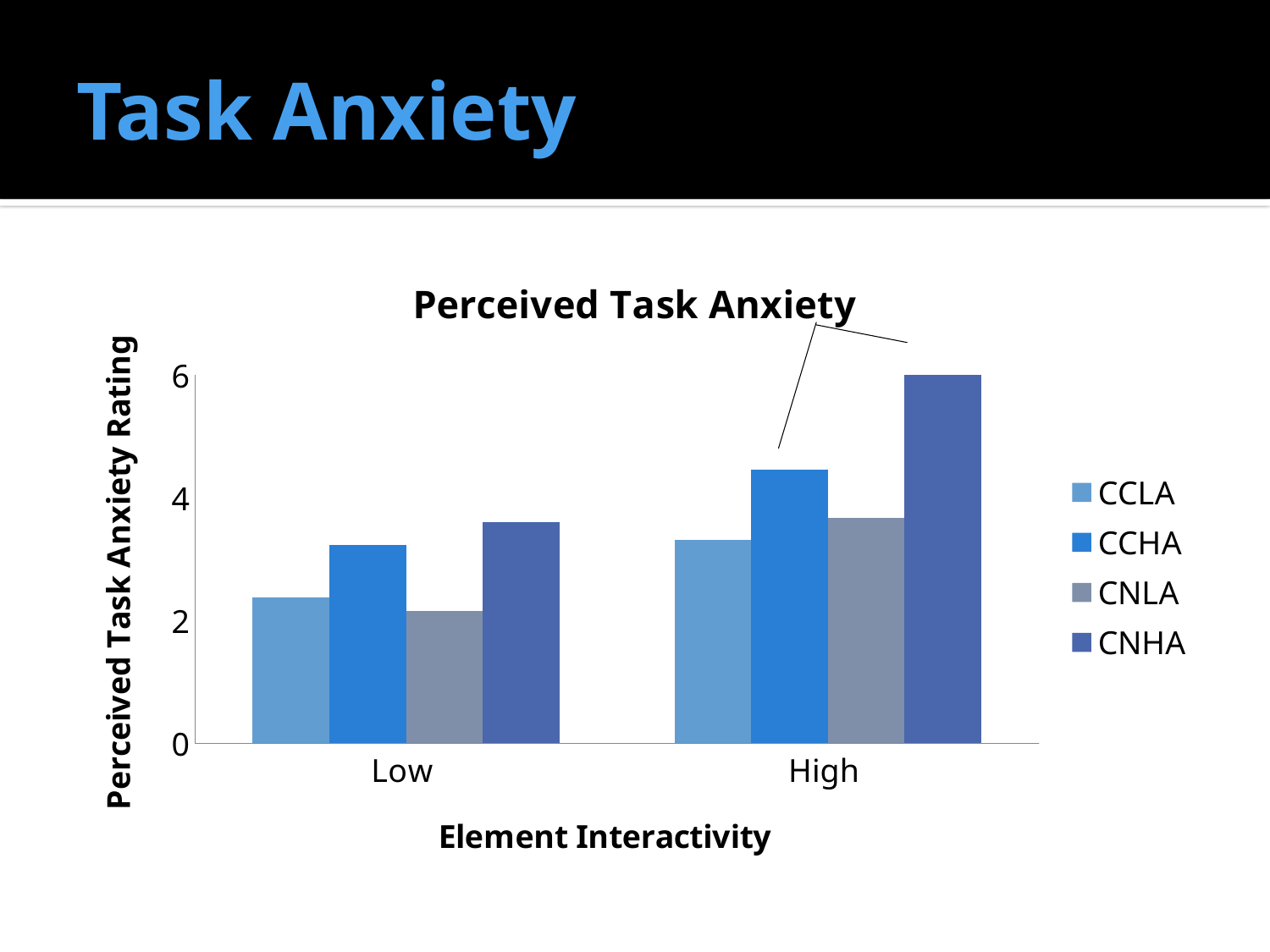
What is the title of the chart? Perceived Task Anxiety What kind of chart is shown on the slide? bar chart Which series has the lowest value for the High category? CCLA Is the value for CCHA at High greater or less than 4? greater Is the value for CCLA at Low greater or less than 2? greater Is the value for CNHA at Low greater or less than 4? less How many categories are shown on the x axis? 2 Which is larger at Low, CCHA or CNLA? CCHA Which is larger, the CNHA value at Low or the CNHA value at High? High Which series has the highest value for the High category? CNHA Do the CCHA values rise or fall from Low to High? rise How many series does the legend list? 4